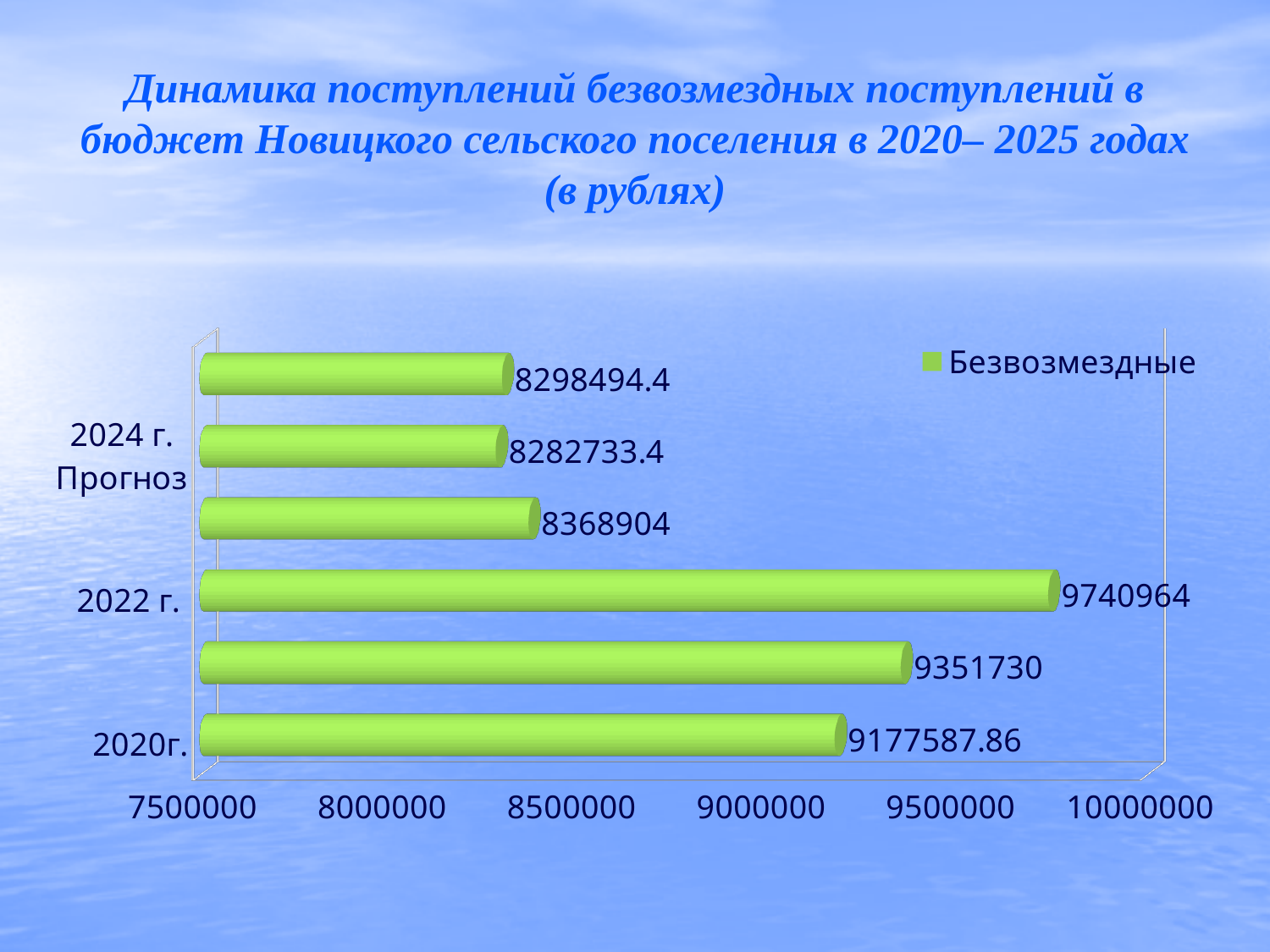
Which category has the highest value? 2022 г. Is the value for 2024 г. Прогноз greater or less than 8500000? less What is the difference between the values for 2022 г. and 2020г.? 563376.14 What is the value for 2024 г. Прогноз? 8282733.4 How many series does the legend list? 1 What kind of chart is shown on the slide? bar chart Which is larger, the value for 2022 г. or the value for 2020г.? 2022 г. What is the value for 2022 г.? 9740964 What is the value for 2020г.? 9177587.86 How many bars are plotted in the chart? 6 Which category has the lowest value? 2024 г. Прогноз What is the name of the series shown in the legend? Безвозмездные